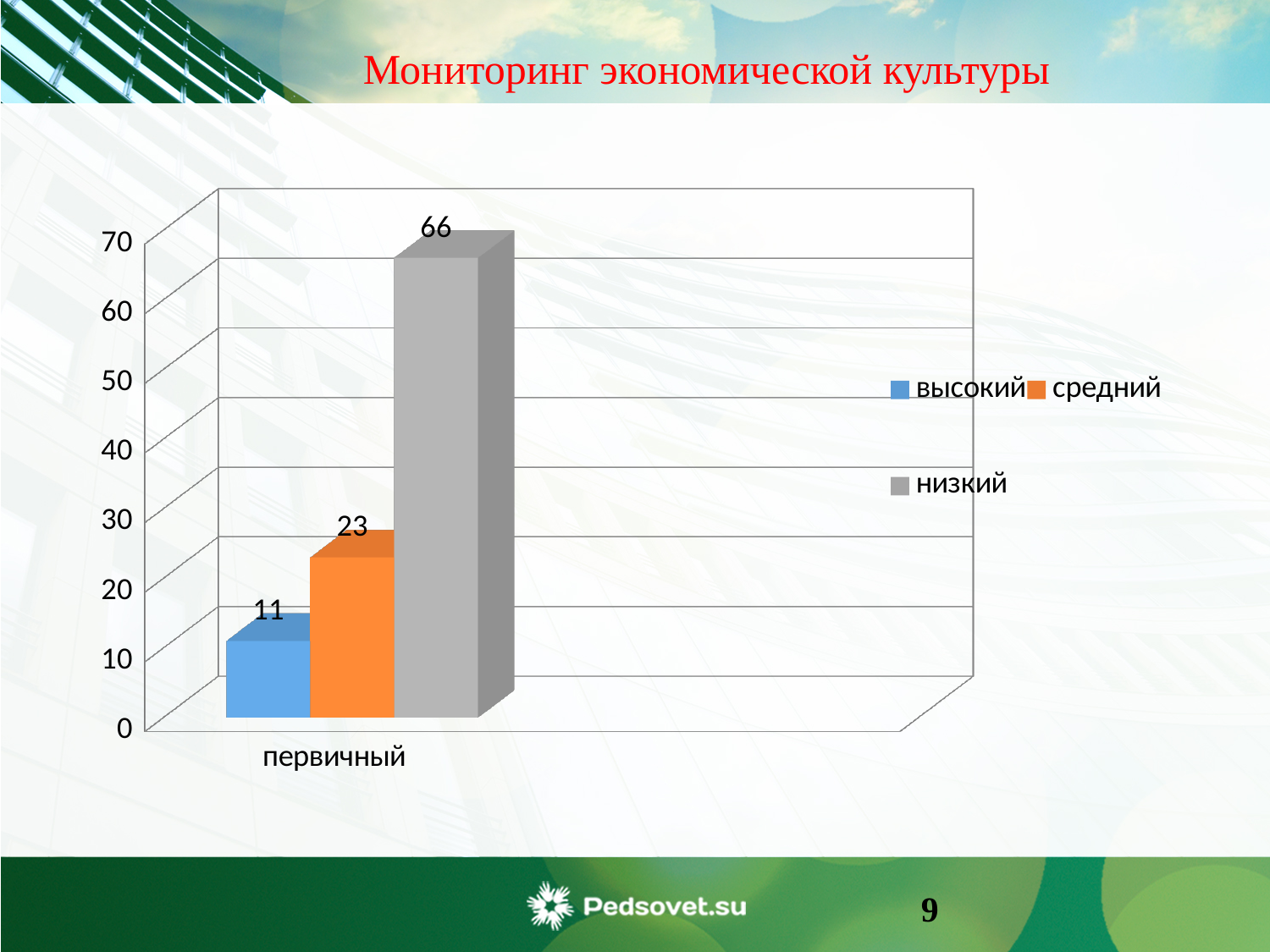
What is the value for высокий in the первичный category? 11 Is the value for низкий greater or less than 60? greater What is the value for средний in the первичный category? 23 What is the difference between the средний and высокий values? 12 Which series has the highest value? низкий What is the difference between the низкий and средний values? 43 What kind of chart is shown on the slide? bar chart What is the title of the slide? Мониторинг экономической культуры How many series does the legend list? 3 Which series has the lowest value? высокий What is the value for низкий in the первичный category? 66 Which is larger, the value for средний or the value for высокий? средний